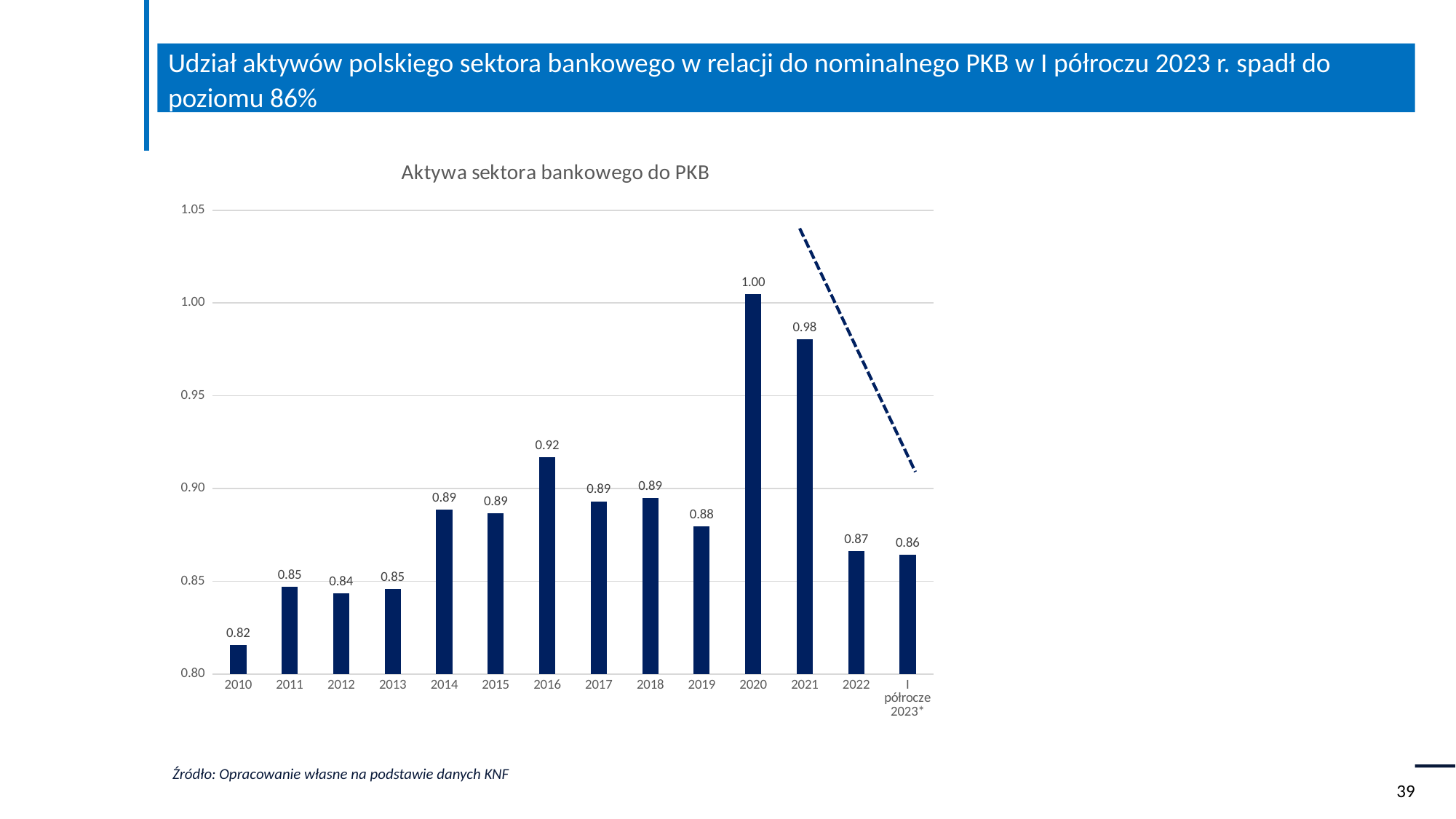
What is the value for I półrocze 2023* in the chart? 0.86 What is the value for 2010 in the chart? 0.82 What is the difference between the values for 2020 and 2010? 0.18 Which year has the lowest value in the chart? 2010 Which is larger, the value for 2016 or the value for 2019? 2016 Which year has the highest value in the chart? 2020 What kind of chart is shown on the slide? bar chart Is the value for 2021 greater or less than 0.95? greater What is the value for 2020 in the chart? 1.00 What is the value for 2016 in the chart? 0.92 What is the title of the chart? Aktywa sektora bankowego do PKB How many categories are shown on the x axis of the chart? 14